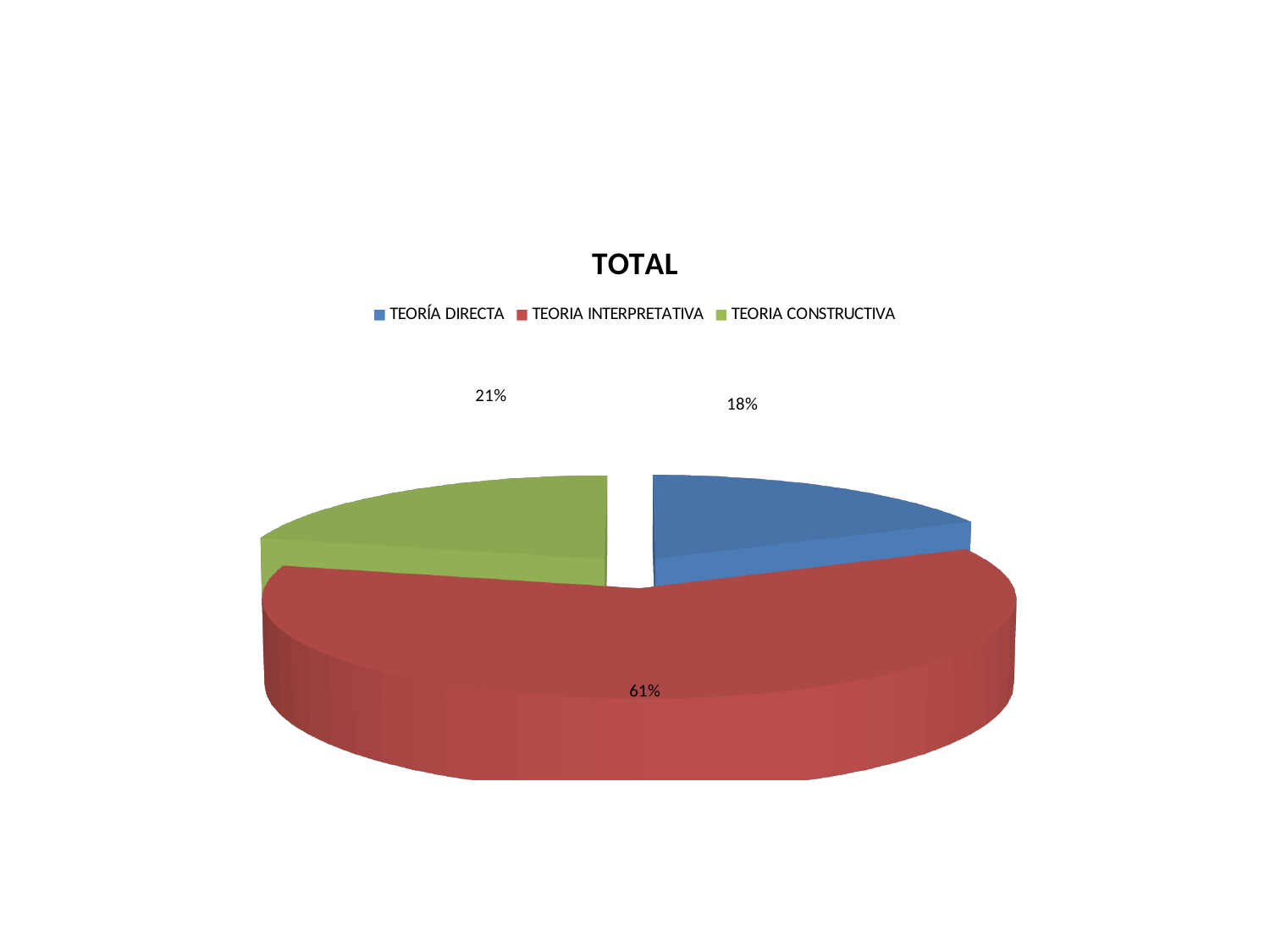
Which is larger, the share for TEORIA CONSTRUCTIVA or the share for TEORÍA DIRECTA? TEORIA CONSTRUCTIVA What percentage is shown for TEORIA CONSTRUCTIVA? 21% How many slices does the pie chart have? 3 What is the difference in percentage points between TEORIA INTERPRETATIVA and TEORIA CONSTRUCTIVA? 40 What percentage is shown for TEORIA INTERPRETATIVA? 61% What kind of chart is shown on the slide? pie chart How many entries does the legend list? 3 What percentage is shown for TEORÍA DIRECTA? 18% Which category has the smallest share of the pie? TEORÍA DIRECTA What is the title of the chart? TOTAL Which category has the largest share of the pie? TEORIA INTERPRETATIVA What colour is the slice for TEORIA CONSTRUCTIVA? green